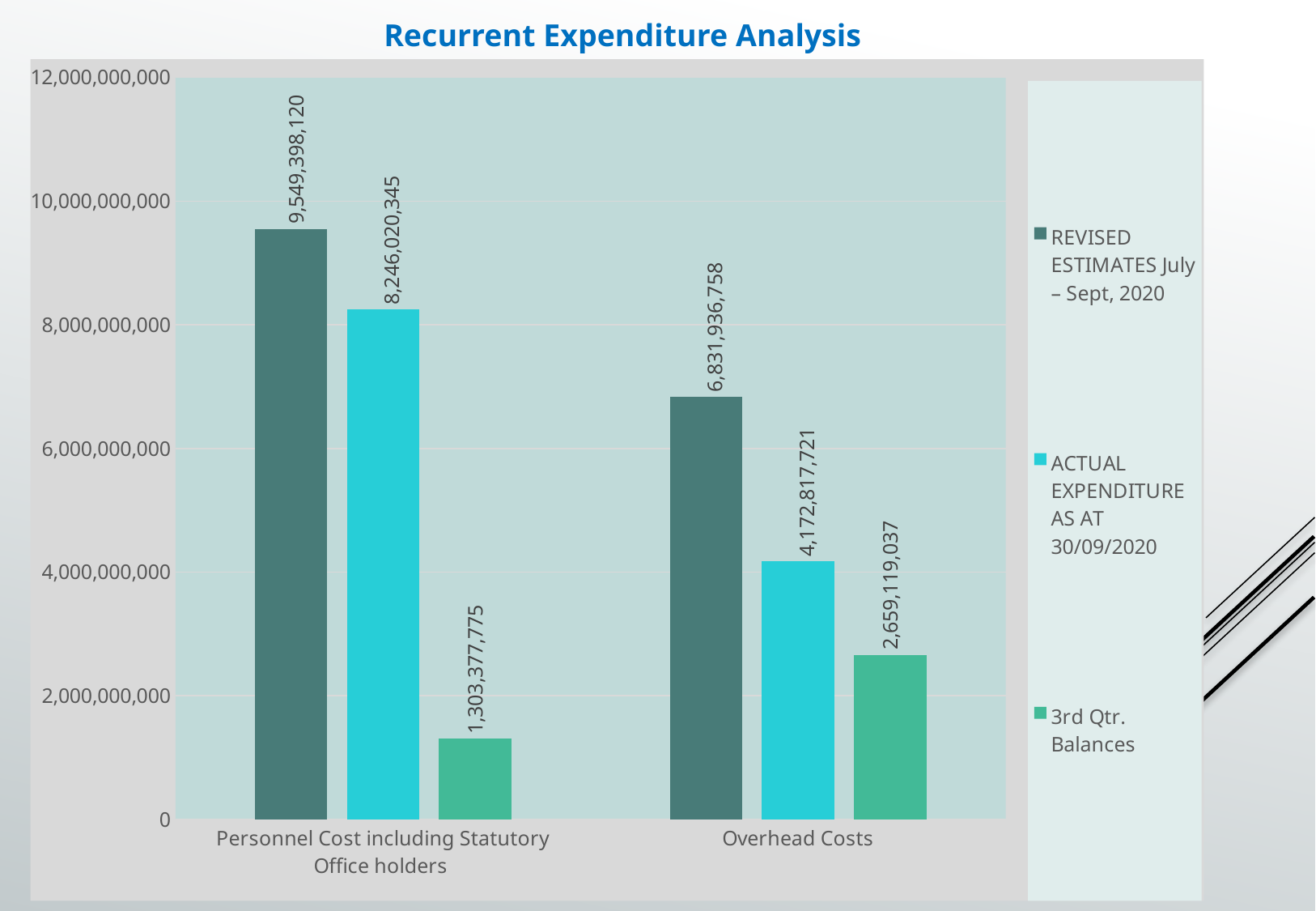
What is the 3rd Qtr. Balances value for Overhead Costs? 2,659,119,037 Which category has the lowest 3rd Qtr. Balances value? Personnel Cost including Statutory Office holders What is the ACTUAL EXPENDITURE AS AT 30/09/2020 value for Overhead Costs? 4,172,817,721 What is the 3rd Qtr. Balances value for Personnel Cost including Statutory Office holders? 1,303,377,775 What is the difference between the REVISED ESTIMATES July – Sept, 2020 values for Personnel Cost including Statutory Office holders and Overhead Costs? 2,717,461,362 What is the REVISED ESTIMATES July – Sept, 2020 value for Personnel Cost including Statutory Office holders? 9,549,398,120 Which is larger: the ACTUAL EXPENDITURE AS AT 30/09/2020 for Personnel Cost including Statutory Office holders or for Overhead Costs? Personnel Cost including Statutory Office holders What is the difference between the REVISED ESTIMATES July – Sept, 2020 and the ACTUAL EXPENDITURE AS AT 30/09/2020 for Overhead Costs? 2,659,119,037 Which category has the highest REVISED ESTIMATES July – Sept, 2020 value? Personnel Cost including Statutory Office holders What kind of chart is shown on the slide? Bar chart How many series does the legend list? 3 Is the ACTUAL EXPENDITURE AS AT 30/09/2020 value for Personnel Cost including Statutory Office holders greater or less than 8,000,000,000? greater